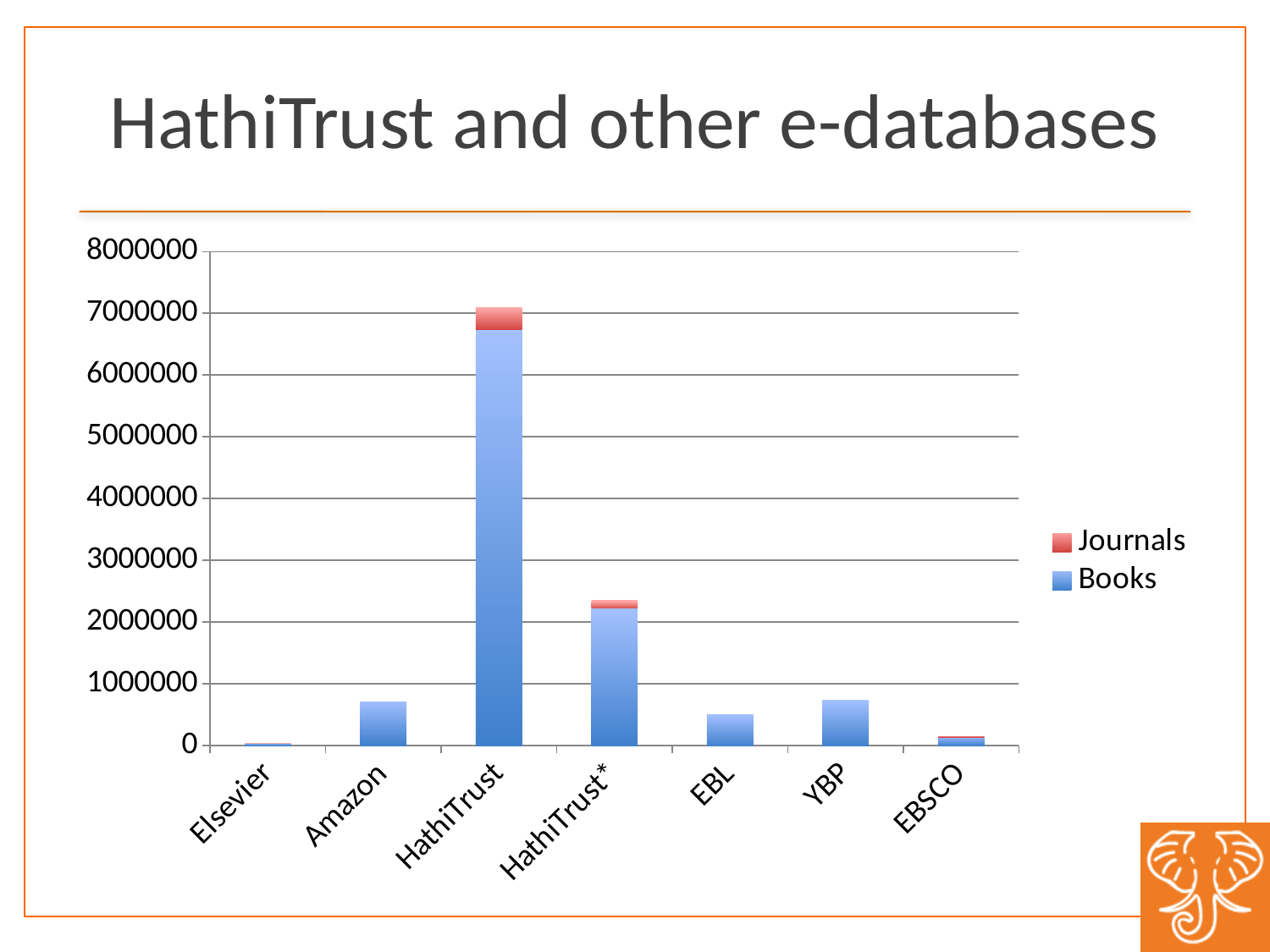
How many categories are shown on the x axis of the chart? 7 Which category has the shortest bar in the chart? Elsevier Which bar is taller, Amazon or EBL? Amazon Is the total value for HathiTrust greater or less than 6000000? greater Is the value for Amazon greater or less than 1000000? less What is the title of the slide containing the chart? HathiTrust and other e-databases How many series does the chart's legend list? 2 Is the total value for HathiTrust* greater or less than 2000000? greater What kind of chart is shown on the slide? Stacked bar chart Which category has the tallest bar in the chart? HathiTrust Which series is shown in red in the chart? Journals Which bar is taller, HathiTrust or HathiTrust*? HathiTrust